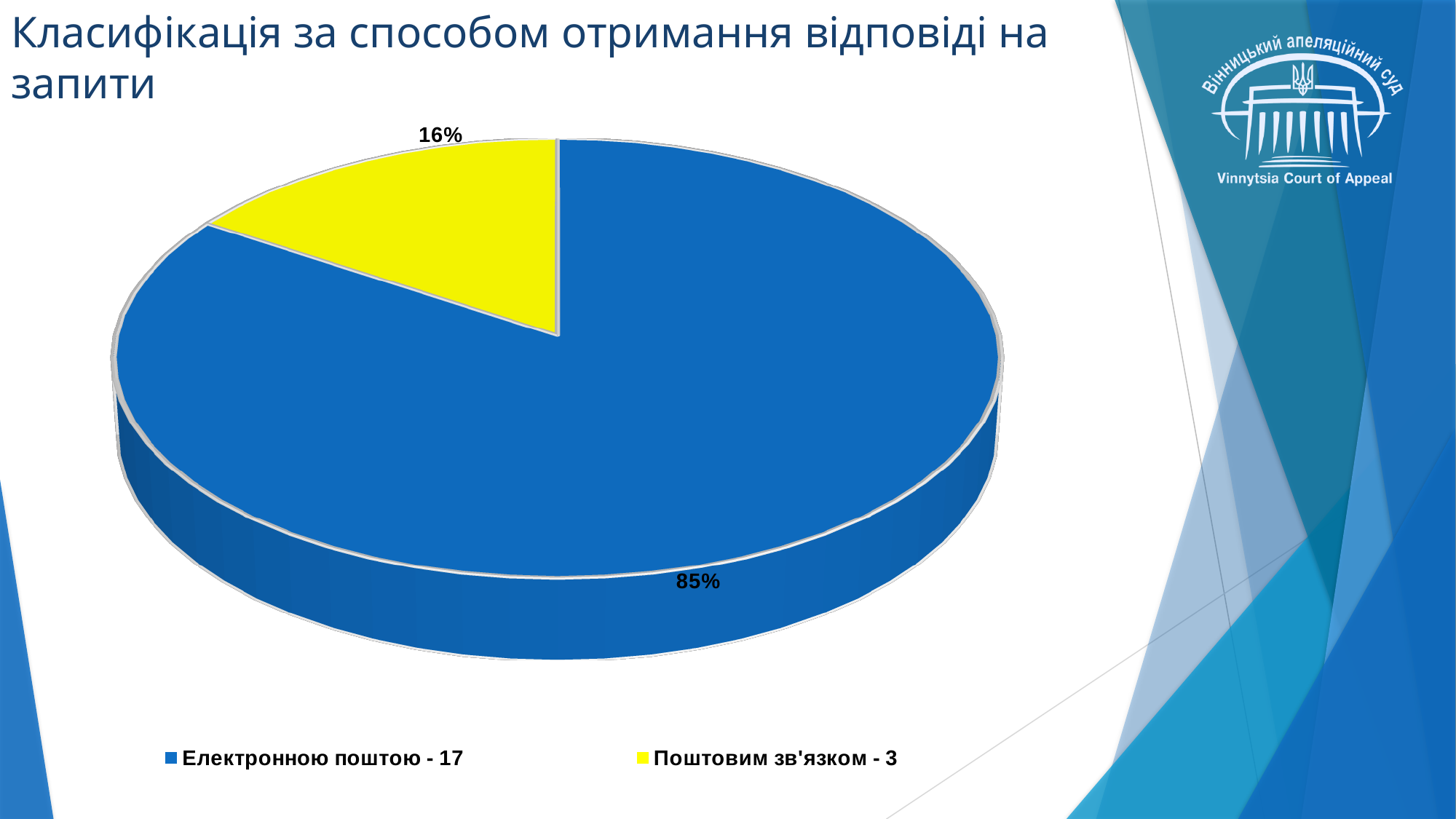
What is the difference in percentage points between the 85% slice and the 16% slice? 69 According to the legend, how many responses were received by e-mail (Електронною поштою)? 17 What colour is the slice for "Поштовим зв'язком - 3"? Yellow What percentage of the pie does the slice for "Поштовим зв'язком - 3" represent? 16% Which is larger: the slice for "Електронною поштою" or the slice for "Поштовим зв'язком"? Електронною поштою How many entries does the legend list? 2 How many slices does the pie chart have? 2 Which category has the largest slice of the pie? Електронною поштою - 17 Which category has the smallest slice of the pie? Поштовим зв'язком - 3 What kind of chart is shown on the slide? Pie chart What percentage of the pie does the slice for "Електронною поштою - 17" represent? 85% According to the legend, how many responses were received by post (Поштовим зв'язком)? 3